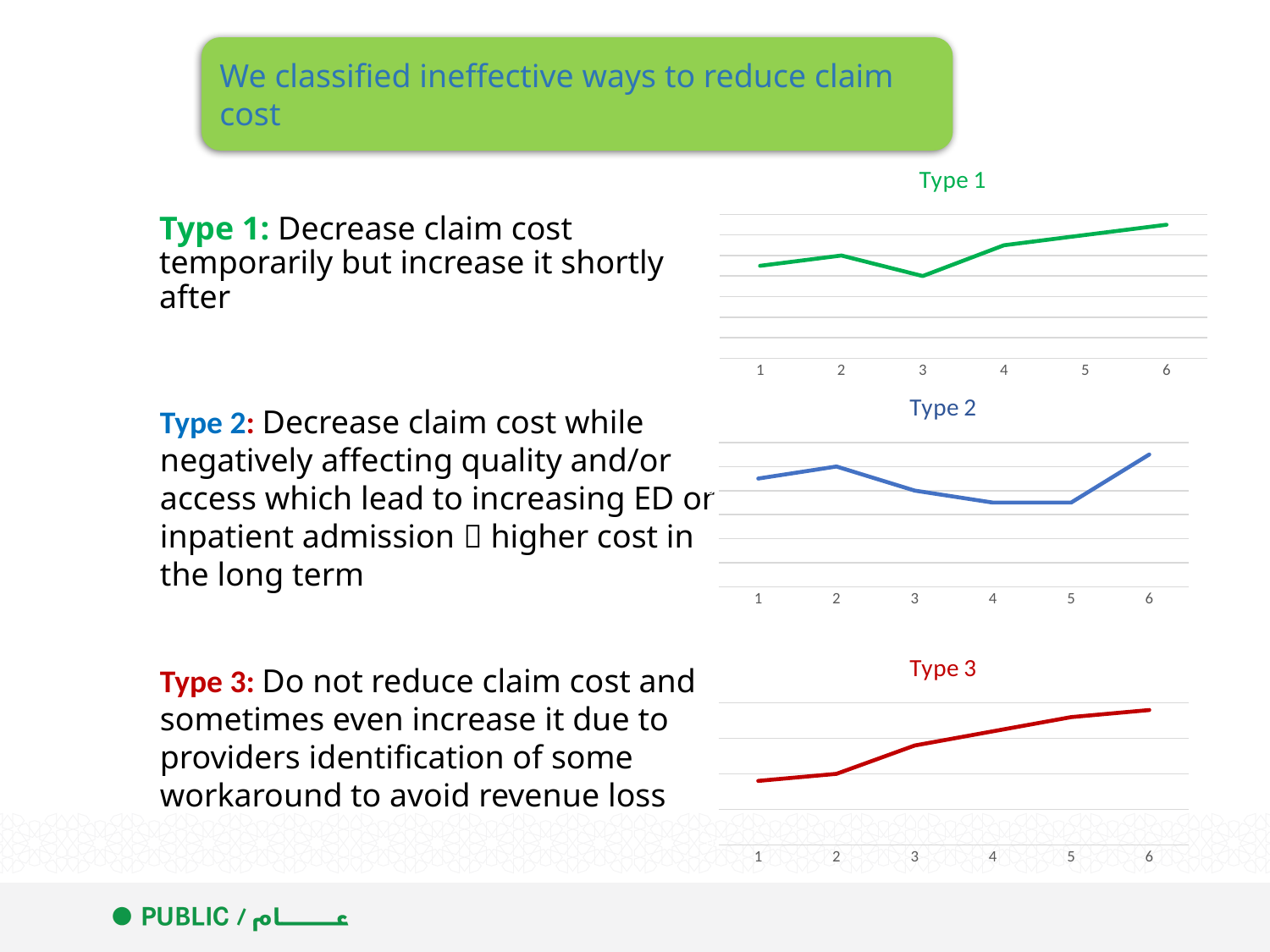
In the "Type 2" chart, at which x-axis point is the line highest? 6 How many charts are shown on the slide? 3 In the "Type 2" chart, do the values rise or fall from point 2 to point 4? fall How many points are plotted along the x axis of the "Type 3" chart? 6 In the "Type 3" chart, do the values rise or fall from point 1 to point 6? rise In the "Type 1" chart, is the value at point 6 higher or lower than the value at point 1? higher What kind of chart is the "Type 1" chart? line chart What colour is the line in the "Type 3" chart? red In the "Type 3" chart, at which x-axis point is the line lowest? 1 In the "Type 2" chart, is the value at point 2 higher or lower than the value at point 4? higher In the "Type 1" chart, at which x-axis point is the line lowest? 3 In the "Type 1" chart, at which x-axis point is the line highest? 6